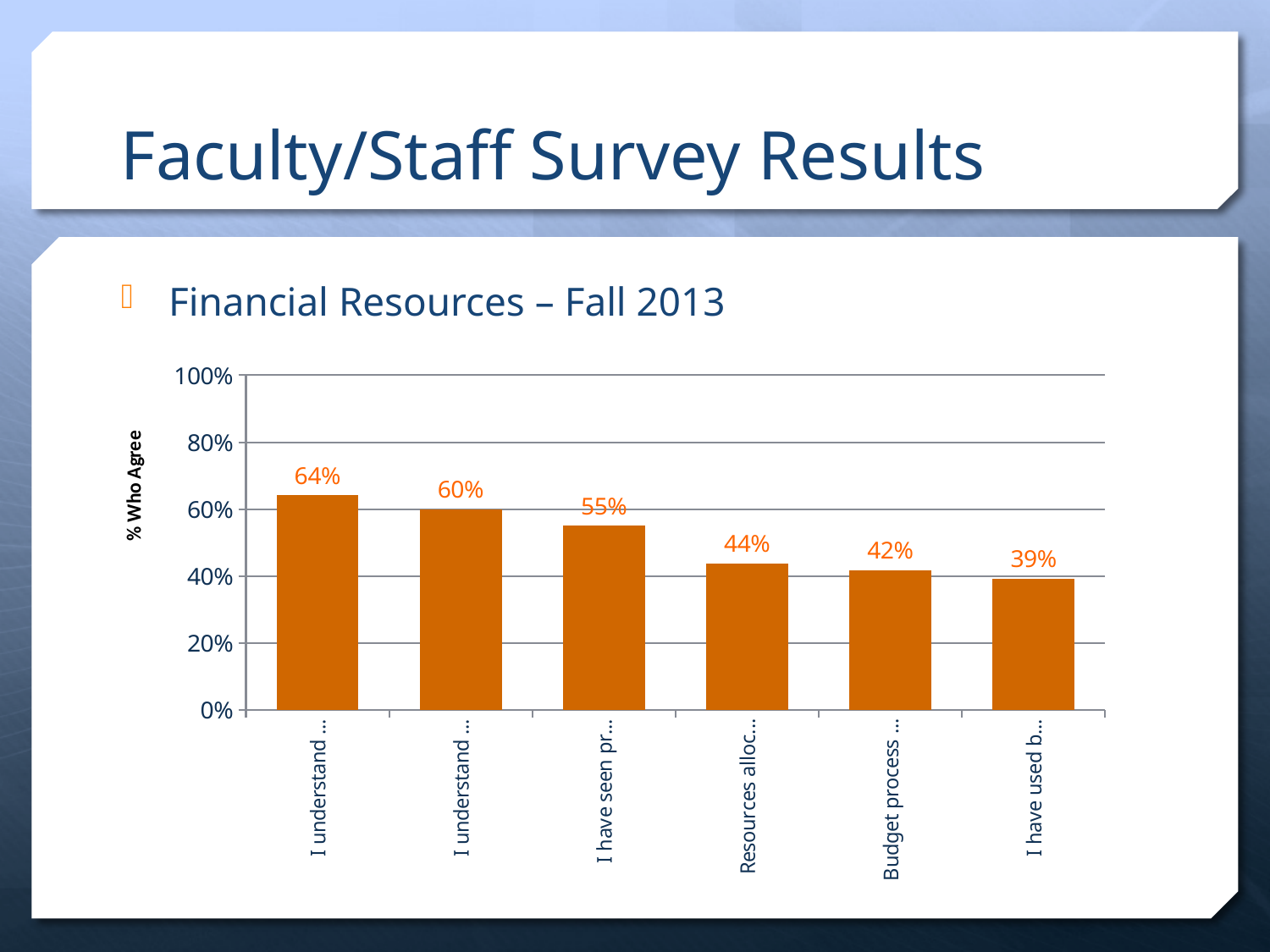
Which bar has the lowest value in the chart? The last (rightmost) bar, "I have used b...", at 39% Which is larger: the value for "I have seen pr..." or the value for "Resources alloc..."? I have seen pr... (55%) What is the value of the last (rightmost) bar, labelled "I have used b..."? 39% What type of chart is shown on the slide? Bar chart What is the difference between the highest bar (64%) and the lowest bar (39%)? 25 percentage points What is the value of the first (leftmost) bar in the chart? 64% What is the label of the vertical axis? % Who Agree What is the value of the bar labelled "Budget process ..."? 42% Which bar has the highest value in the chart? The first (leftmost) bar, at 64% What is the value of the bar labelled "Resources alloc..."? 44% How many bars are shown in the chart? 6 Is the value for "Budget process ..." greater or less than 60%? less